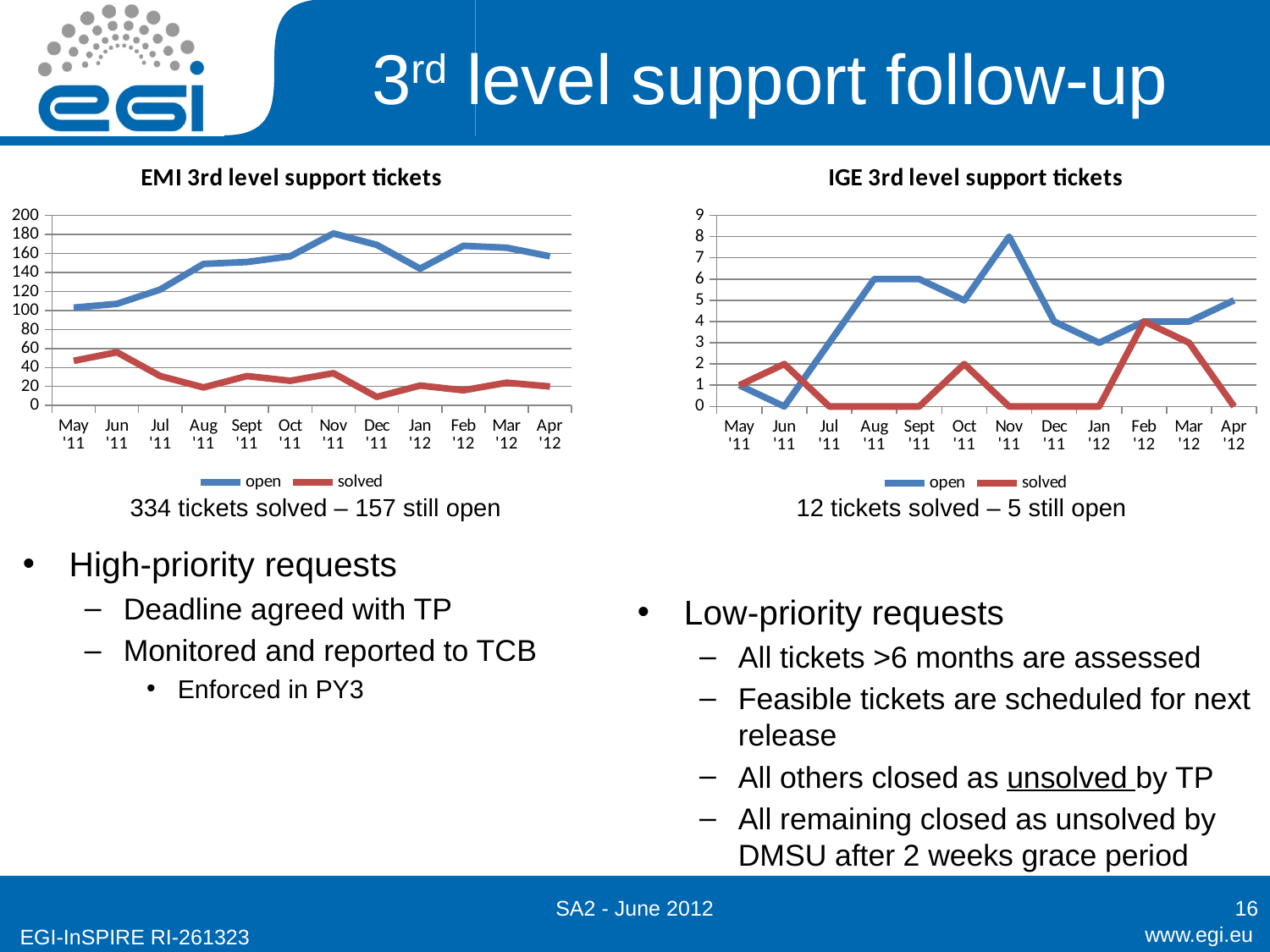
In the 'IGE 3rd level support tickets' chart, what is the value of the open series in Aug '11? 6 How many series does the legend of the 'IGE 3rd level support tickets' chart list? 2 In the 'IGE 3rd level support tickets' chart, what is the difference between the open and solved values in Nov '11? 8 In the 'IGE 3rd level support tickets' chart, what is the value of the solved series in Feb '12? 4 What type of chart is the 'EMI 3rd level support tickets' chart? line chart In the 'EMI 3rd level support tickets' chart, which series has the larger value in May '11, open or solved? open In the 'IGE 3rd level support tickets' chart, in which month does the open series reach its highest value? Nov '11 In the 'EMI 3rd level support tickets' chart, is the solved value for Dec '11 greater or less than 20? less How many months are plotted on the x axis of the 'EMI 3rd level support tickets' chart? 12 In the 'IGE 3rd level support tickets' chart, what is the value of the open series in Nov '11? 8 In the 'EMI 3rd level support tickets' chart, in which month does the open series reach its highest value? Nov '11 In the 'EMI 3rd level support tickets' chart, is the open value for Nov '11 greater or less than 160? greater